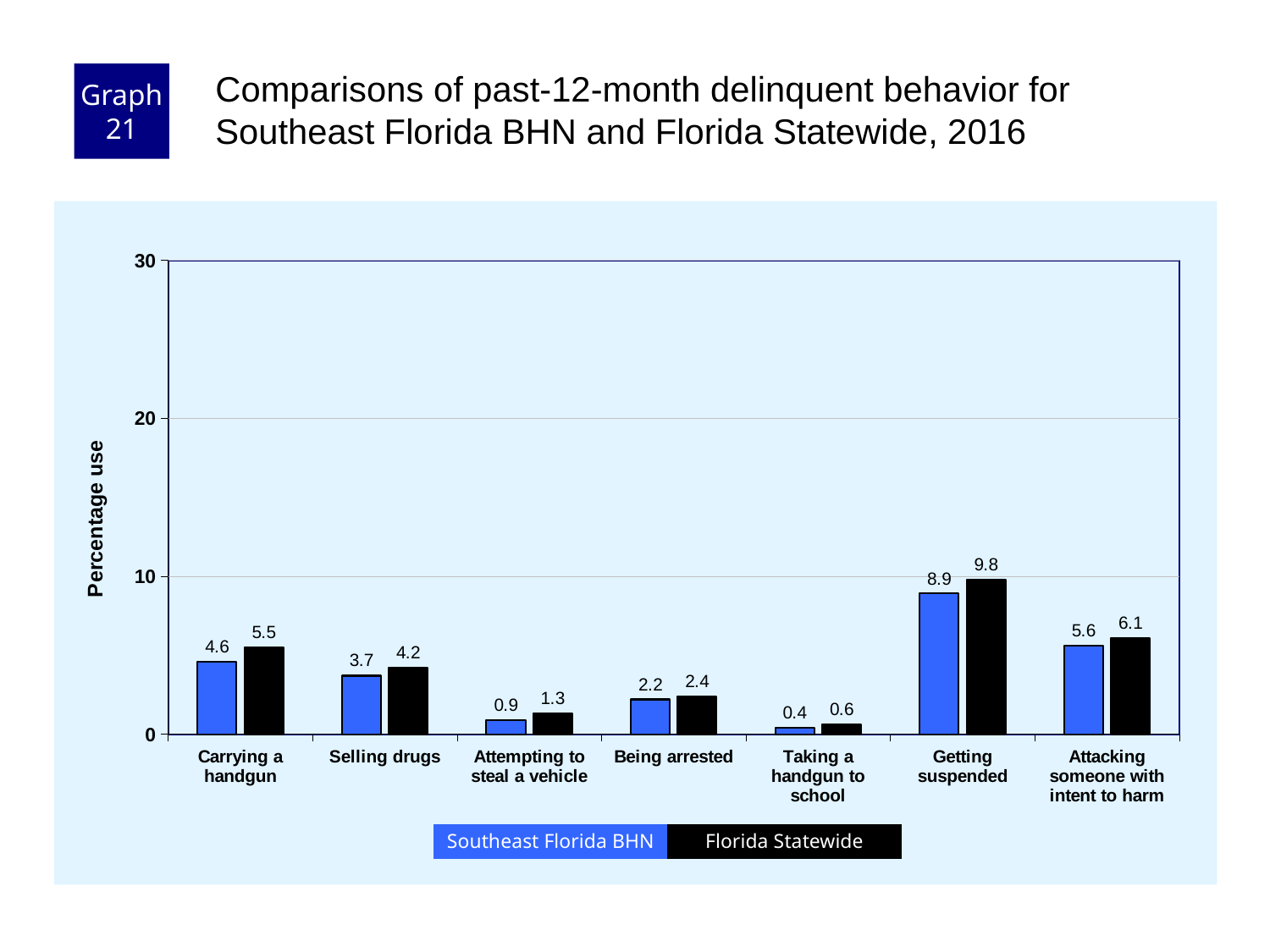
How many series does the legend list? 2 What is the difference between the Florida Statewide and Southeast Florida BHN values for Getting suspended? 0.9 What is the Southeast Florida BHN value for Taking a handgun to school? 0.4 Which category has the lowest Southeast Florida BHN value? Taking a handgun to school How many categories are shown on the x axis? 7 What is the Florida Statewide value for Carrying a handgun? 5.5 What is the label of the y axis? Percentage use Which is larger for Selling drugs: Southeast Florida BHN or Florida Statewide? Florida Statewide Which category has the highest Florida Statewide value? Getting suspended What kind of chart is shown on the slide? bar chart Is the Florida Statewide value for Attacking someone with intent to harm greater or less than 10? less What is the Southeast Florida BHN value for Getting suspended? 8.9